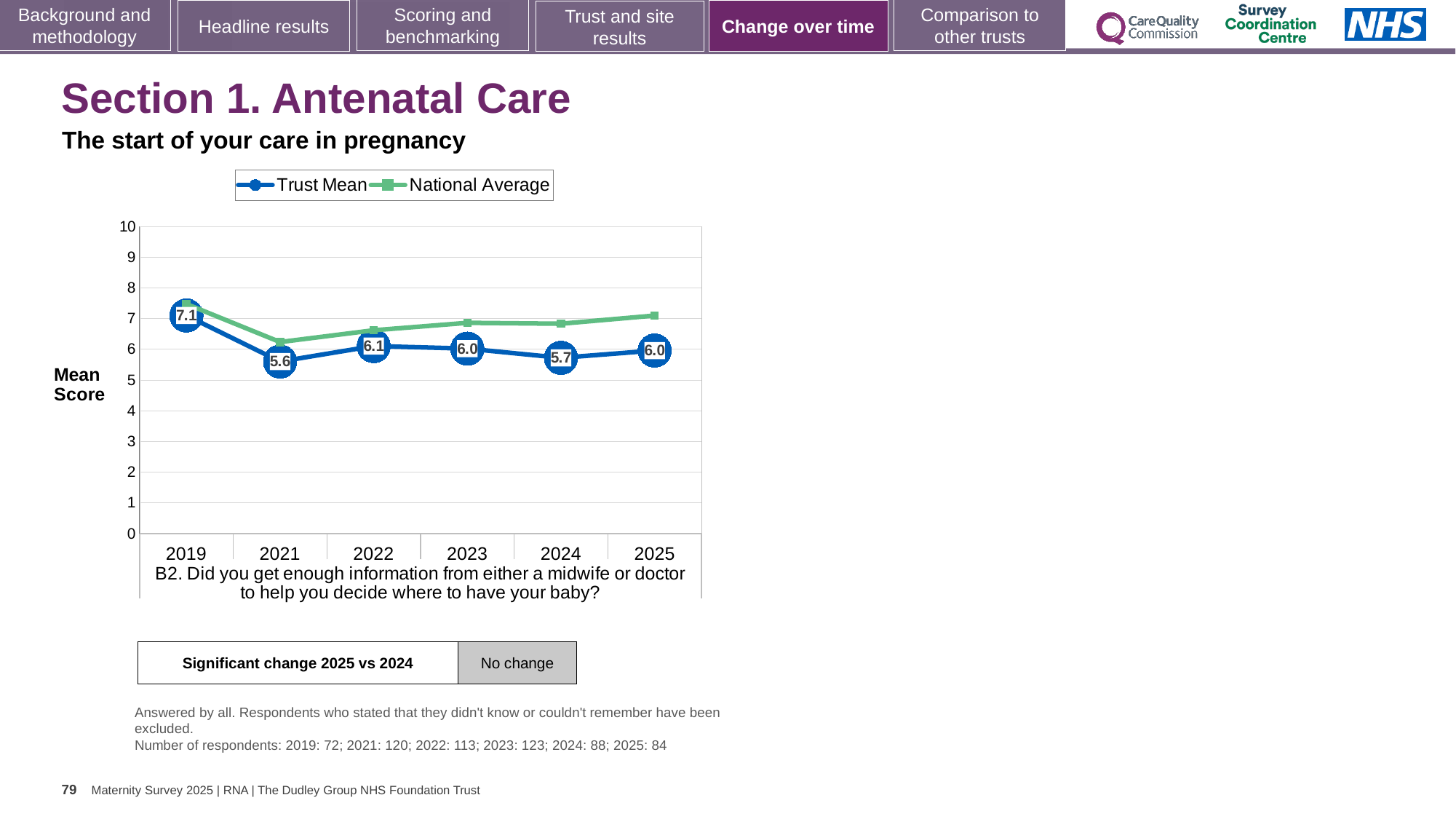
What kind of chart is shown on the slide? Line chart What is the Trust Mean value for 2019? 7.1 In which year is the Trust Mean lowest? 2021 Is the National Average value for 2019 greater or less than 7? greater Which is larger, the Trust Mean in 2022 or in 2024? 2022 How many series does the legend list? 2 In which year is the Trust Mean highest? 2019 What is the Trust Mean value for 2025? 6.0 How many years are plotted on the x axis? 6 What is the Trust Mean value for 2021? 5.6 What is the difference between the Trust Mean in 2019 and in 2021? 1.5 What is the Trust Mean value for 2024? 5.7